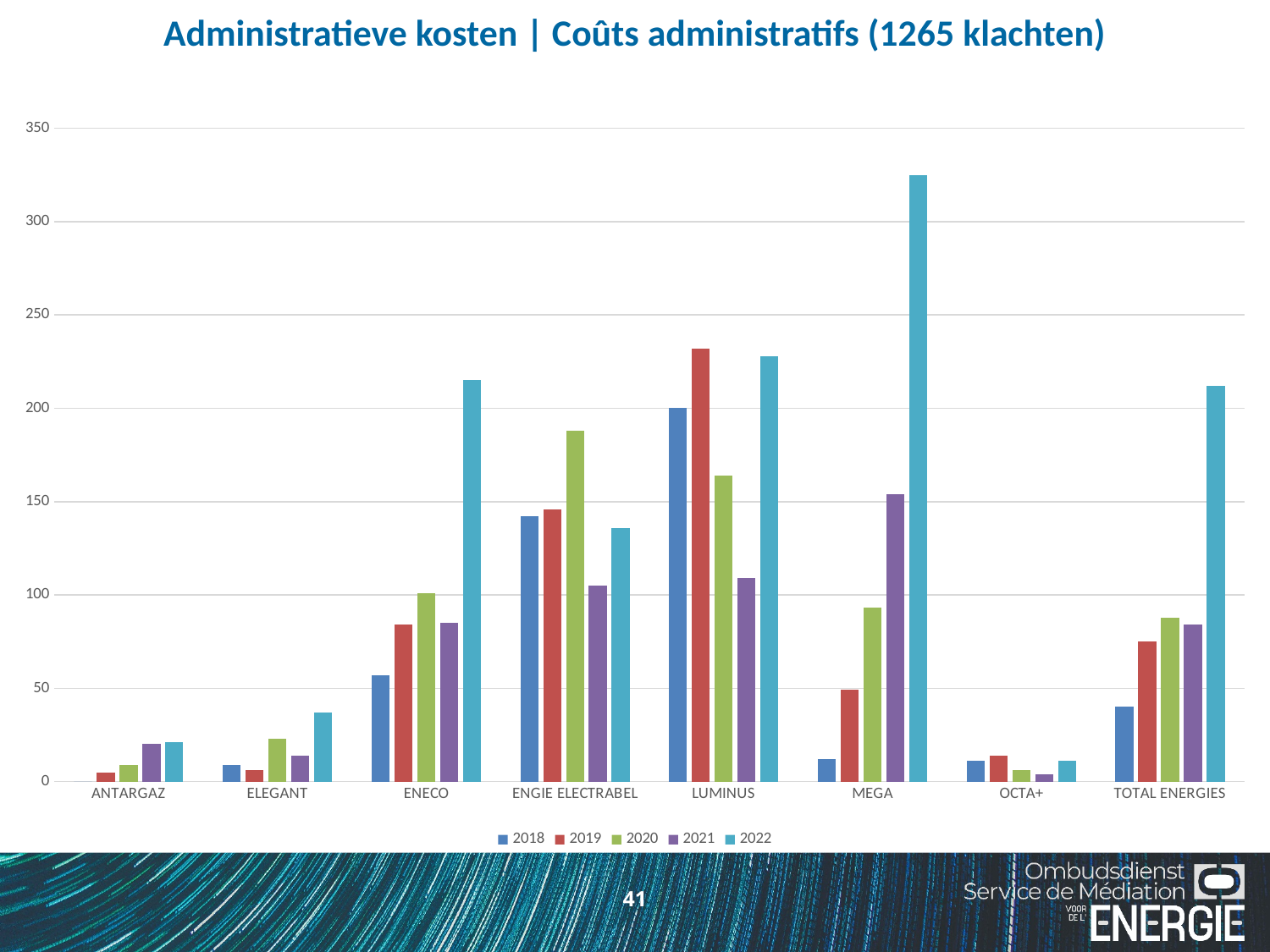
Which category has the highest 2018 bar? LUMINUS What is the title of the chart? Administratieve kosten | Coûts administratifs (1265 klachten) Do the values for MEGA rise or fall from 2018 to 2022? rise How many series does the legend list? 5 Is the 2022 value for MEGA greater or less than 300? greater Which category has the lowest 2022 bar? OCTA+ Which is larger, the 2019 value for LUMINUS or the 2019 value for ENGIE ELECTRABEL? LUMINUS What kind of chart is shown on the slide? bar chart Is the 2022 value for ENECO greater or less than 200? greater Which category has the highest 2022 bar? MEGA Is the 2020 value for ENGIE ELECTRABEL greater or less than 150? greater How many categories (suppliers) are shown on the x axis? 8